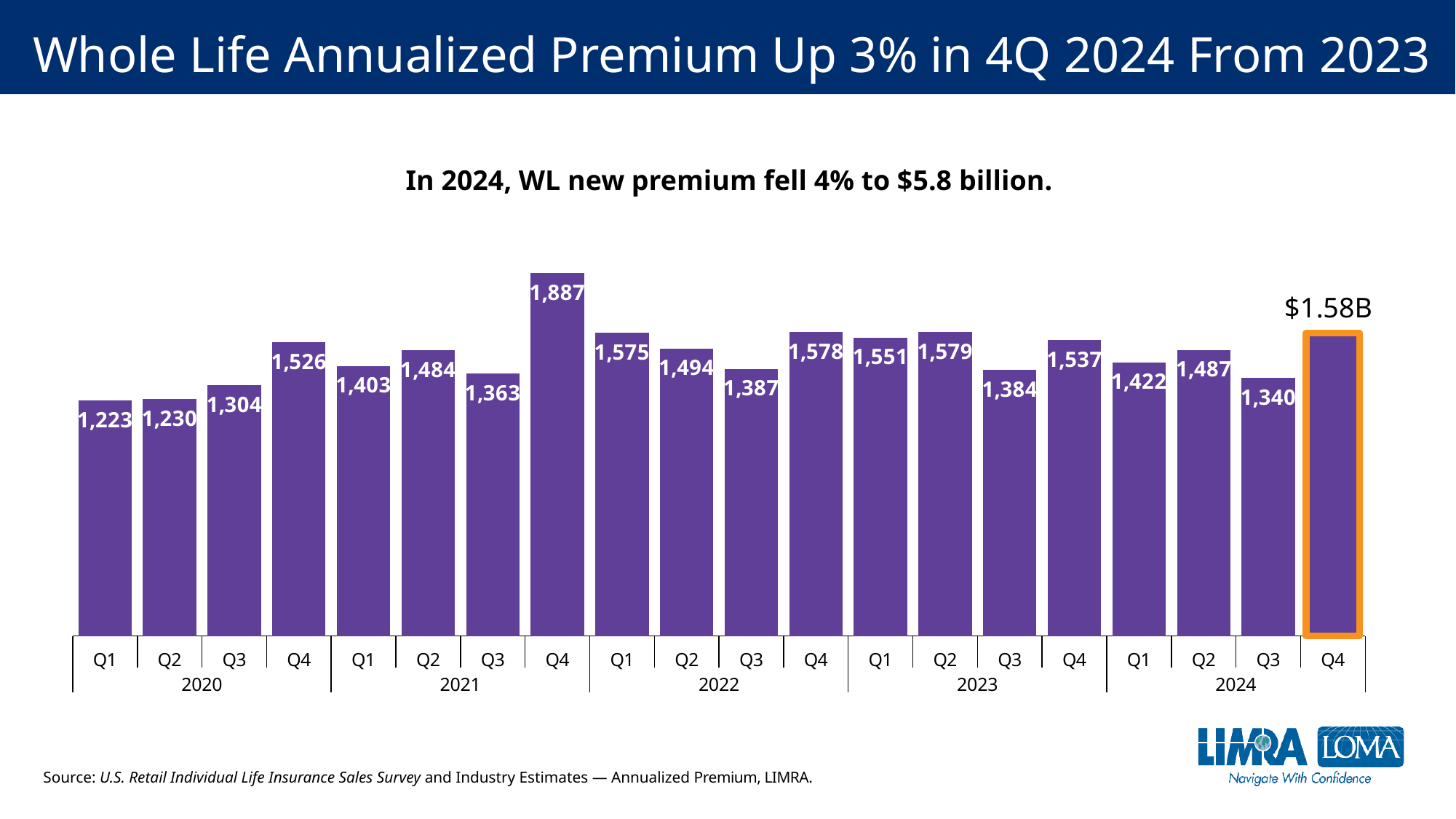
How many bars are plotted in the chart? 20 What is the value for Q4 2021? 1,887 What is the difference between the values for Q4 2021 and Q3 2021? 524 Which quarter has the highest value in the chart? Q4 2021 Which quarter has the lowest value in the chart? Q1 2020 What is the value for Q3 2023? 1,384 What is the difference between the values for Q4 2020 and Q1 2020? 303 Do the values rise or fall across the four quarters of 2020? Rise Which is larger, the value for Q1 2022 or the value for Q1 2023? Q1 2022 What is the value labeled for Q4 2024? $1.58B What is the value for Q1 2020? 1,223 What type of chart is shown on the slide? Bar chart